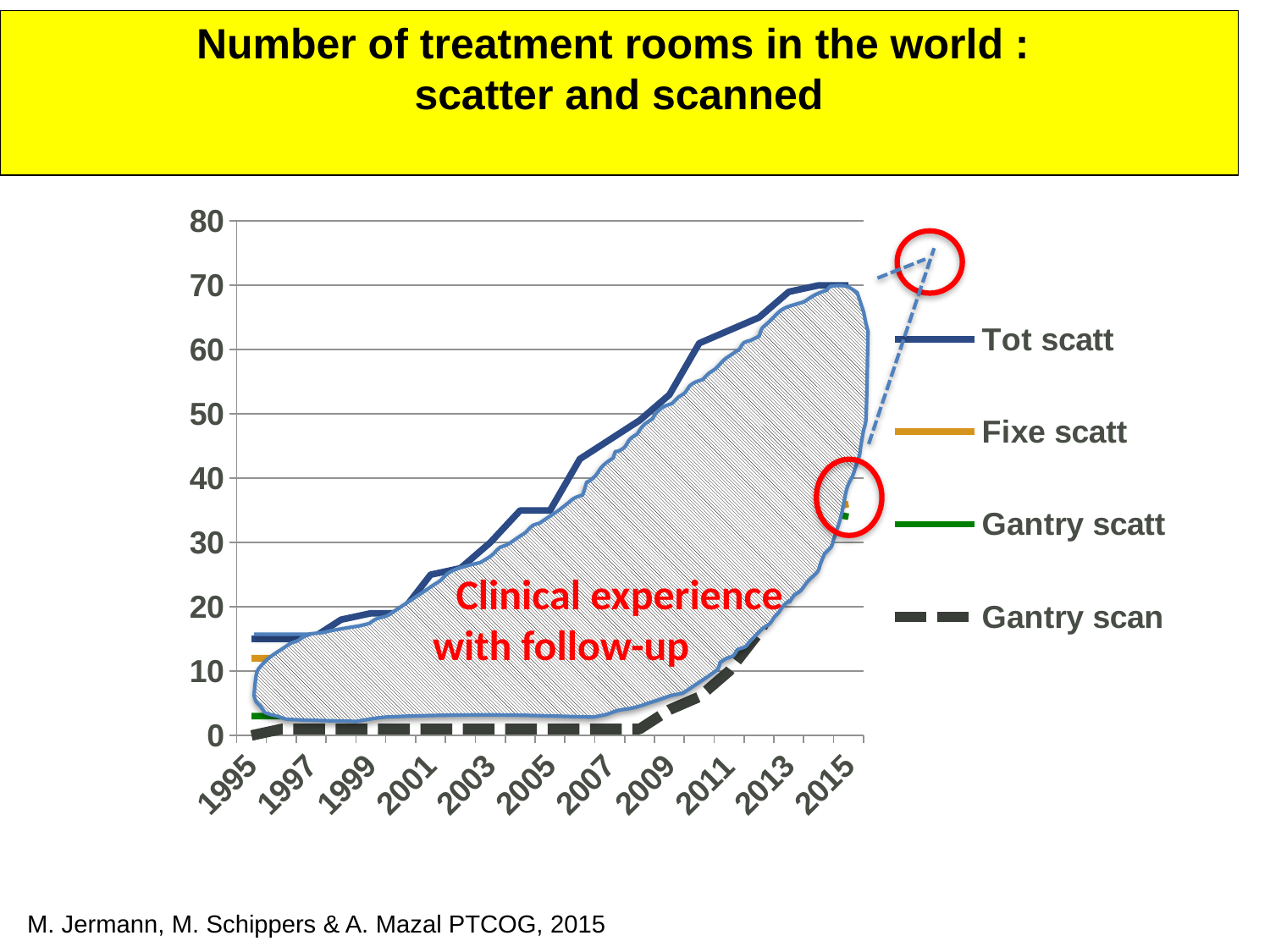
How many series does the legend list? 4 Is the value of Gantry scan in 2013 greater or less than 10? greater Is the value of Tot scatt in 1995 greater or less than 20? less Is the value of Gantry scan in 2005 greater or less than 10? less How many year labels are shown on the x axis? 11 In 2013, which series has the larger value, Tot scatt or Gantry scan? Tot scatt What is the title of the chart? Number of treatment rooms in the world : scatter and scanned Which series is drawn with a dashed line? Gantry scan What kind of chart is shown on the slide? line chart Does the Tot scatt series rise or fall from 1995 to 2015? rise